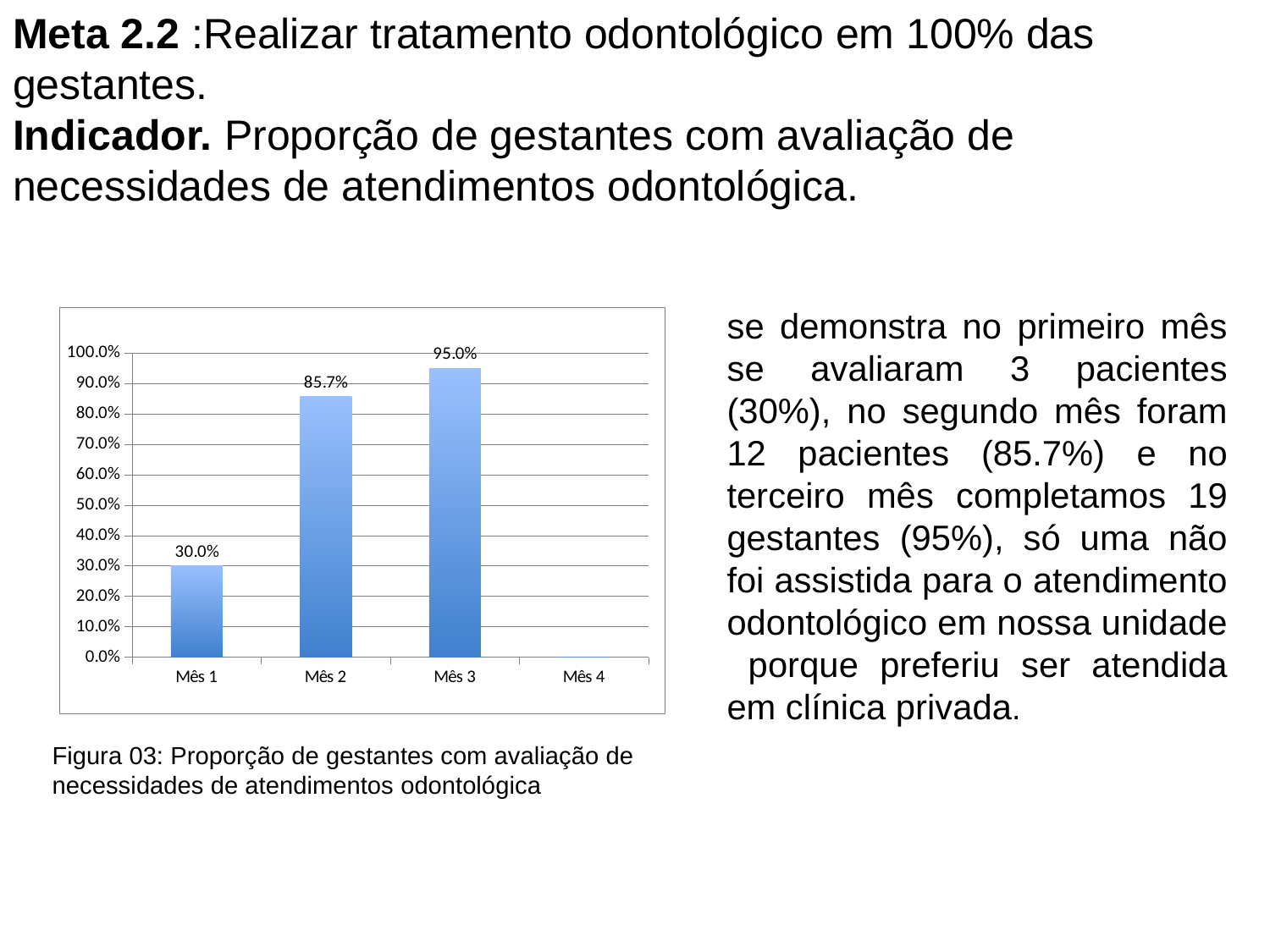
What is the value for Mês 1? 30.0% Which is larger, the value for Mês 1 or the value for Mês 2? Mês 2 Do the values rise or fall from Mês 1 to Mês 3? rise What is the difference between the values for Mês 3 and Mês 2? 9.3% What is the value for Mês 2? 85.7% Is the value for Mês 1 greater or less than 50.0%? less What kind of chart is shown on the slide? bar chart Among the months with a labelled bar, which has the lowest value? Mês 1 How many month categories are shown on the x axis? 4 What is the difference between the values for Mês 2 and Mês 1? 55.7% What is the value for Mês 3? 95.0% Which month has the highest value? Mês 3